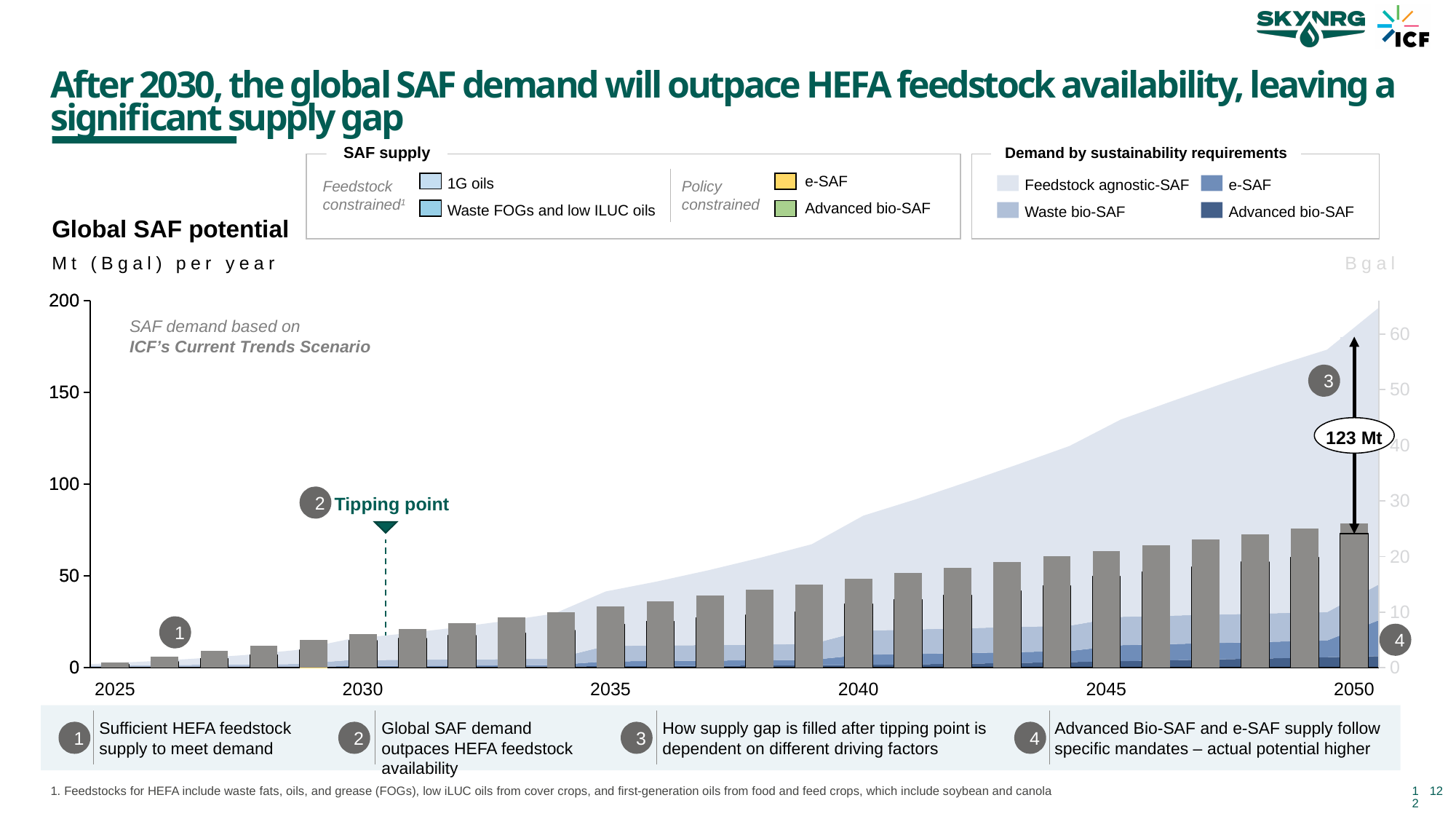
Is the grey supply bar for 2050 greater or less than 50 on the left axis? greater How many entries does the 'Demand by sustainability requirements' legend list? 4 Which is larger, the grey supply bar for 2040 or for 2030? 2040 Do the grey supply bars rise or fall from 2025 to 2050? Rise What kind of chart is used on the slide? Combined bar and area chart In which year is the grey supply bar the shortest? 2025 How many entries does the 'SAF supply' legend list? 4 What is the size of the supply gap labelled on the chart for 2050? 123 Mt What is the title of the chart on the slide? Global SAF potential In which year is the grey supply bar the tallest? 2050 Is the grey supply bar for 2030 greater or less than 50 on the left axis? less Which scenario is the SAF demand in the chart based on? ICF's Current Trends Scenario